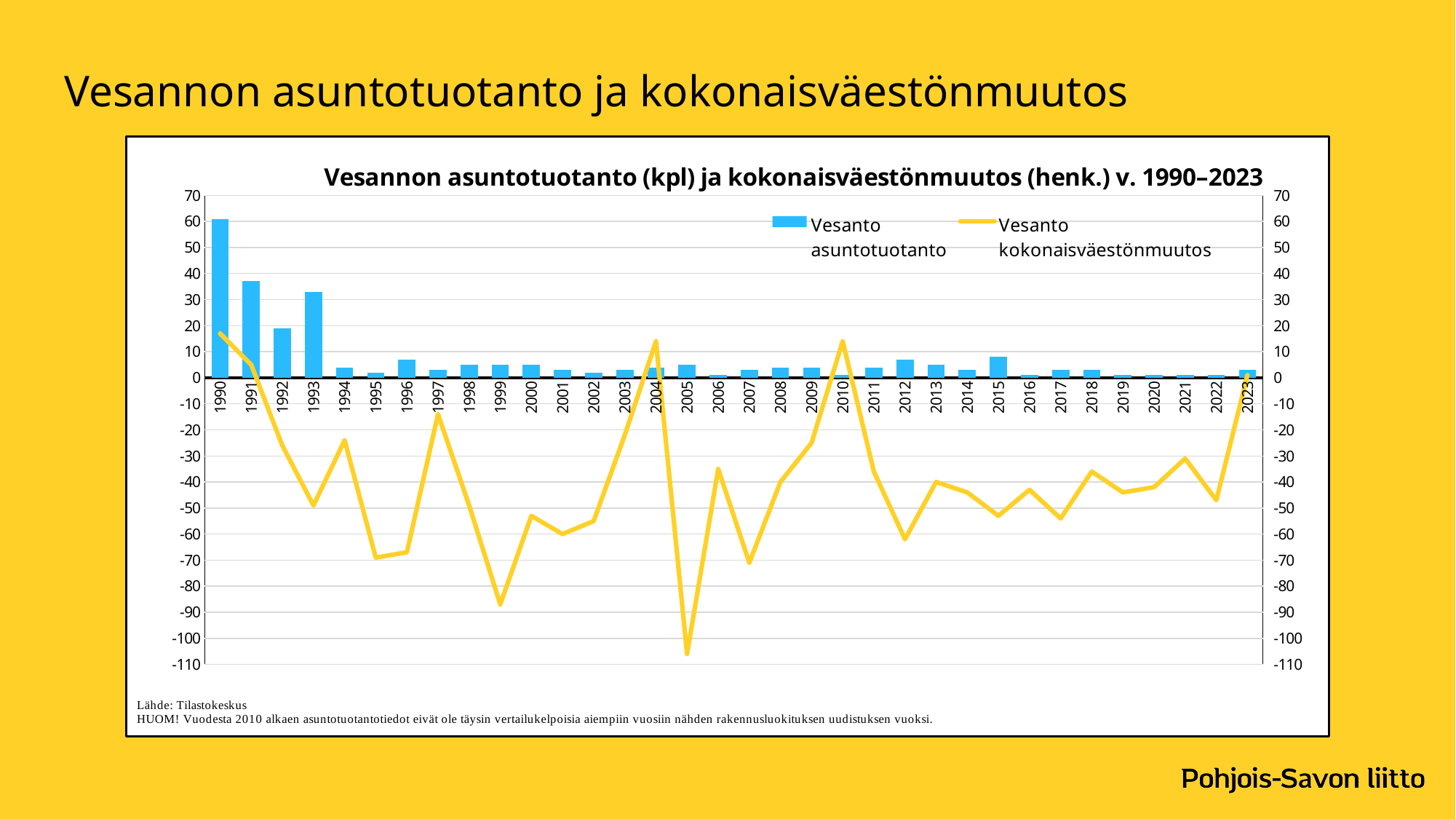
Is the value for Vesanto kokonaisväestönmuutos in 1999 greater or less than -80? less Do the Vesanto asuntotuotanto bars rise or fall from 1990 to 1995? fall Is the value for Vesanto kokonaisväestönmuutos in 2004 greater or less than 10? greater How many years are shown on the x axis? 34 How many series does the legend list? 2 Which is larger, the Vesanto asuntotuotanto value in 1990 or in 1991? 1990 Is the value for Vesanto asuntotuotanto in 1990 greater or less than 50? greater What kind of chart is shown on the slide? A combined bar and line chart Which year has the highest value for Vesanto asuntotuotanto? 1990 Which year has the lowest value for Vesanto kokonaisväestönmuutos? 2005